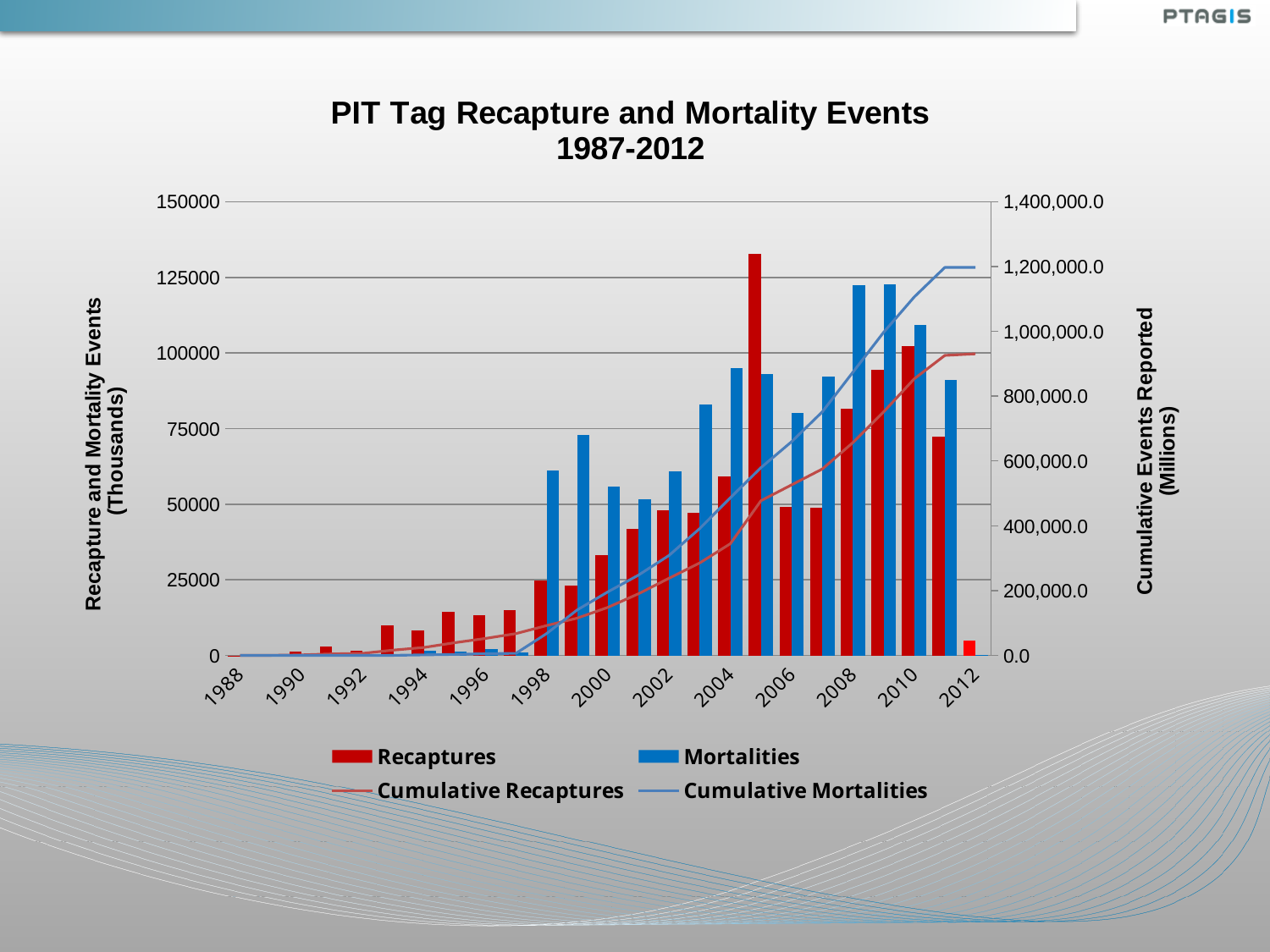
In 2010, which is larger, Recaptures or Mortalities? Mortalities Is the Mortalities value for 1998 greater or less than 75000? less Is the Mortalities value for 2000 greater or less than 50000? greater Does the Cumulative Mortalities line rise or fall from 1988 to 2012? Rises What colour are the Recaptures bars? Red Is the Recaptures value for 2004 greater or less than 50000? greater What kind of chart is shown on the slide? A combined bar and line chart In 2008, which is larger, Recaptures or Mortalities? Mortalities What is the title of the chart? PIT Tag Recapture and Mortality Events 1987-2012 How many series does the legend list? 4